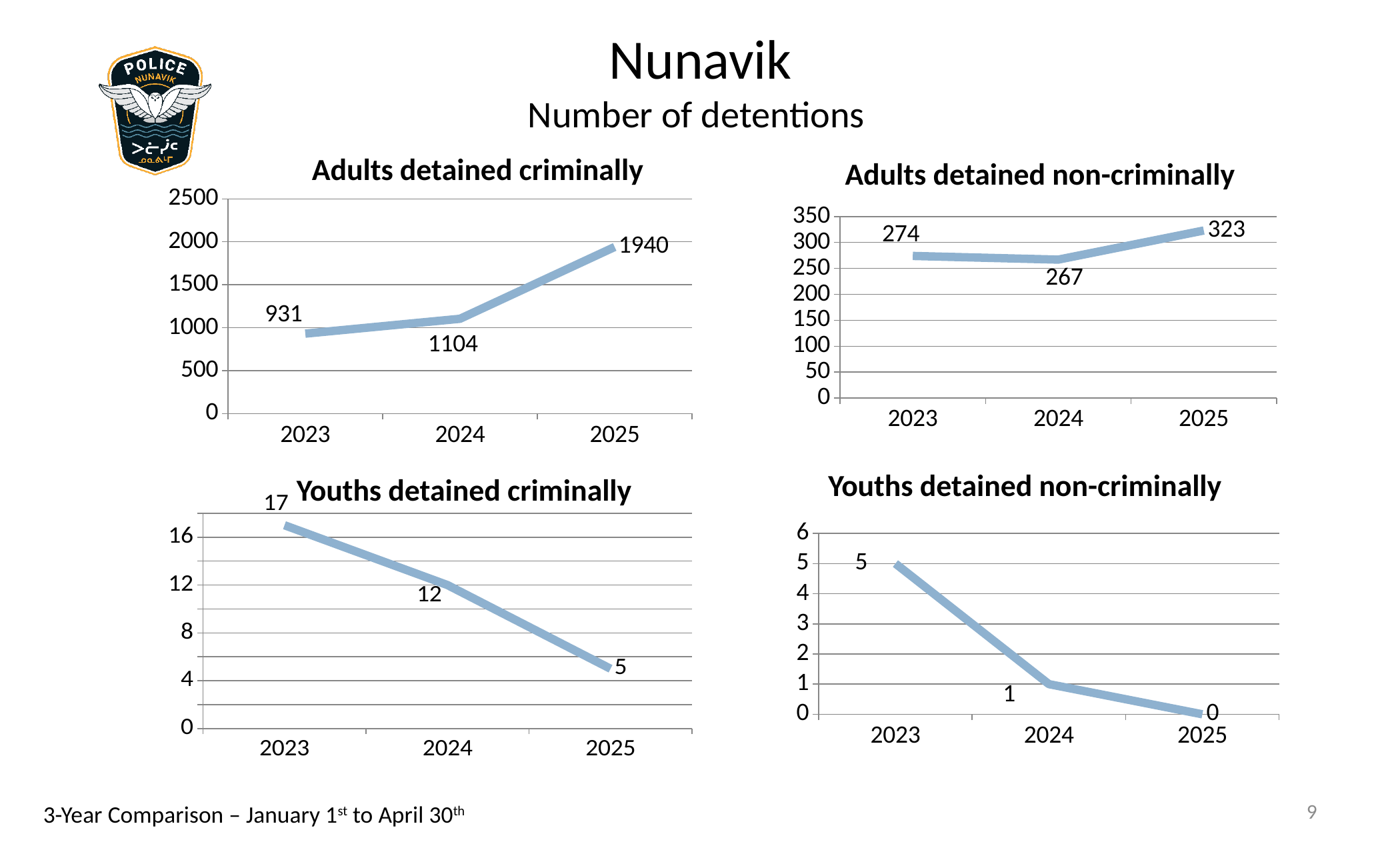
In the 'Adults detained non-criminally' chart, which year has the highest value? 2025 In the 'Youths detained criminally' chart, what is the value for 2024? 12 In the 'Youths detained non-criminally' chart, do the values rise or fall from 2023 to 2025? fall In the 'Youths detained non-criminally' chart, what is the value for 2025? 0 In the 'Adults detained criminally' chart, what is the value for 2023? 931 In the 'Adults detained criminally' chart, what is the difference between the 2025 and 2024 values? 836 How many years are plotted in the 'Adults detained criminally' chart? 3 In the 'Youths detained criminally' chart, which year has the lowest value? 2025 In the 'Adults detained non-criminally' chart, which is larger, the value for 2023 or the value for 2024? 2023 In the 'Adults detained non-criminally' chart, what is the value for 2024? 267 In the 'Adults detained criminally' chart, what is the value for 2025? 1940 What kind of chart is 'Youths detained criminally'? line chart